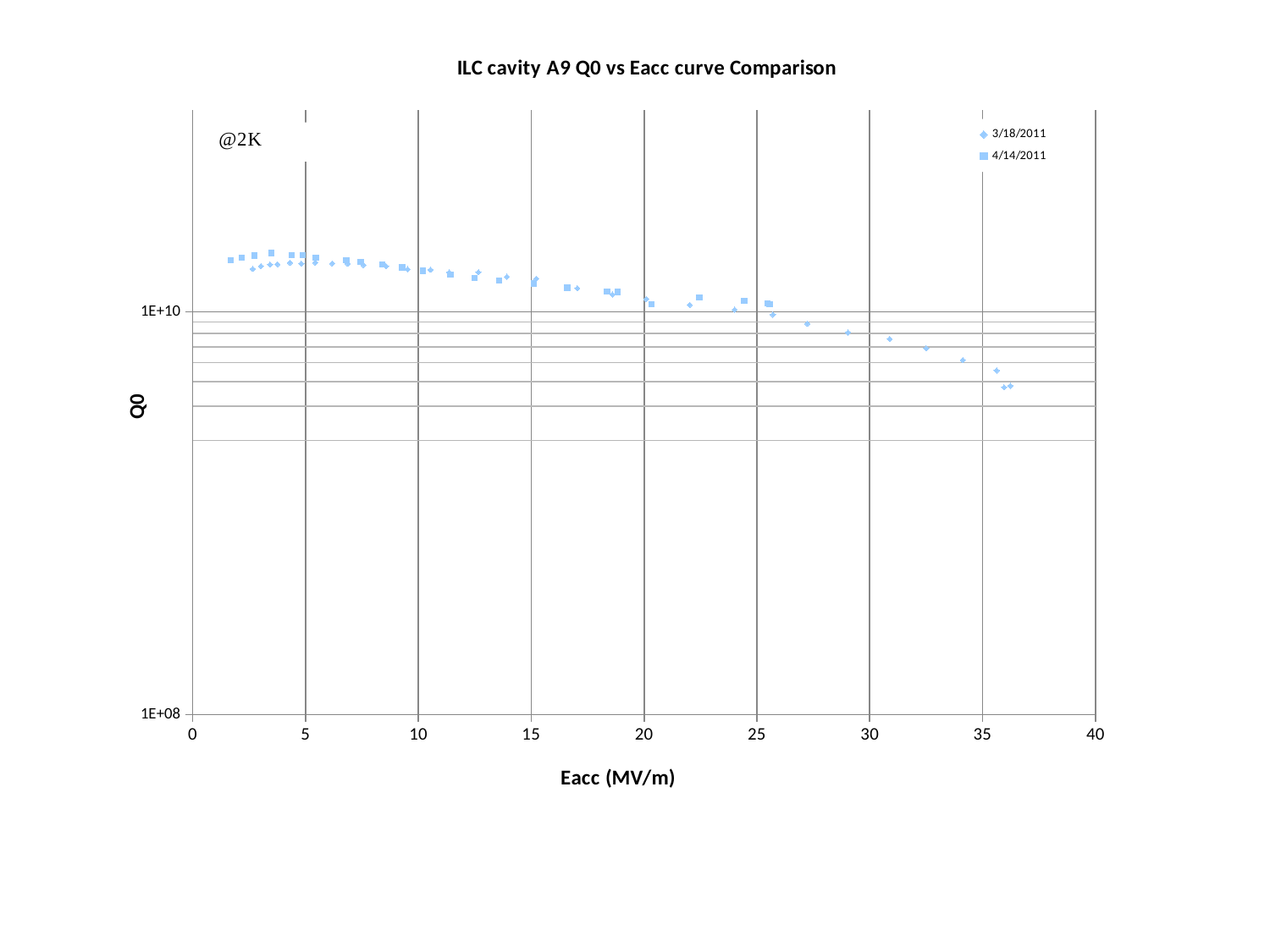
Is the Q0 value for the 4/14/2011 series at about 5 MV/m greater or less than 1E+10? greater Which series reaches the higher Eacc values, 3/18/2011 or 4/14/2011? 3/18/2011 What is the label of the y axis? Q0 What is the lowest value shown on the y axis? 1E+08 Does Q0 for the 3/18/2011 series rise or fall as Eacc increases beyond 25 MV/m? fall What kind of chart is shown on the slide? scatter chart What are the two series named in the legend? 3/18/2011 and 4/14/2011 What is the title of the chart? ILC cavity A9 Q0 vs Eacc curve Comparison How many series does the legend list? 2 Is the Q0 value for the 3/18/2011 series at about 35 MV/m greater or less than 1E+10? less What is the label of the x axis? Eacc (MV/m) What is the highest value shown on the x axis? 40